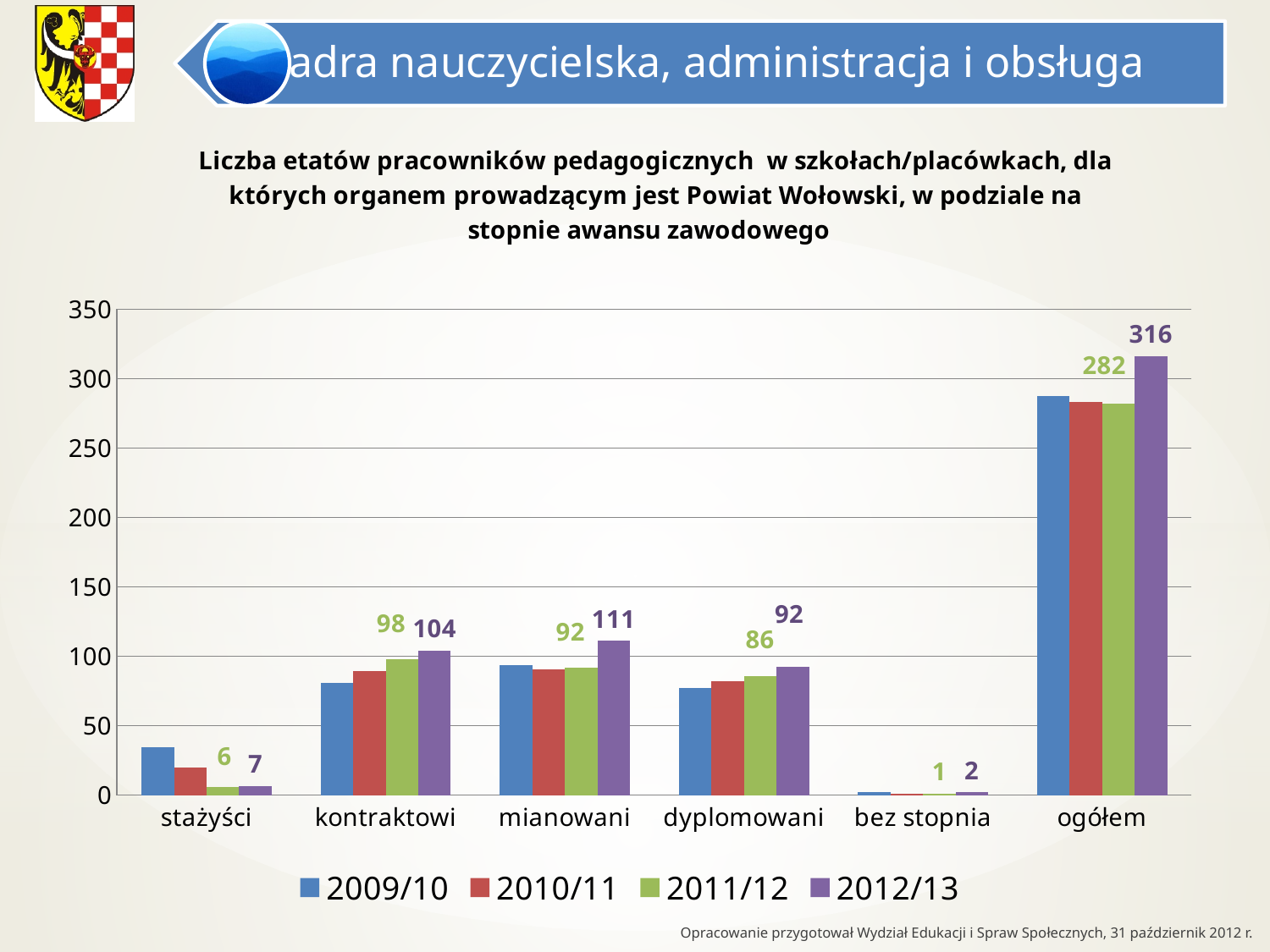
What is the value for ogółem in the 2012/13 series? 316 Which category has the lowest value in the 2011/12 series? bez stopnia What is the difference between the 2012/13 and 2011/12 values for mianowani? 19 Is the value for stażyści in the 2009/10 series greater or less than 50? less Which is larger for dyplomowani: the 2011/12 value or the 2012/13 value? 2012/13 What is the value for kontraktowi in the 2012/13 series? 104 What is the value for stażyści in the 2011/12 series? 6 How many categories are shown on the x axis? 6 What is the value for mianowani in the 2011/12 series? 92 How many series does the legend list? 4 Which category has the highest value in the 2012/13 series? ogółem What is the difference between the 2012/13 and 2011/12 values for ogółem? 34